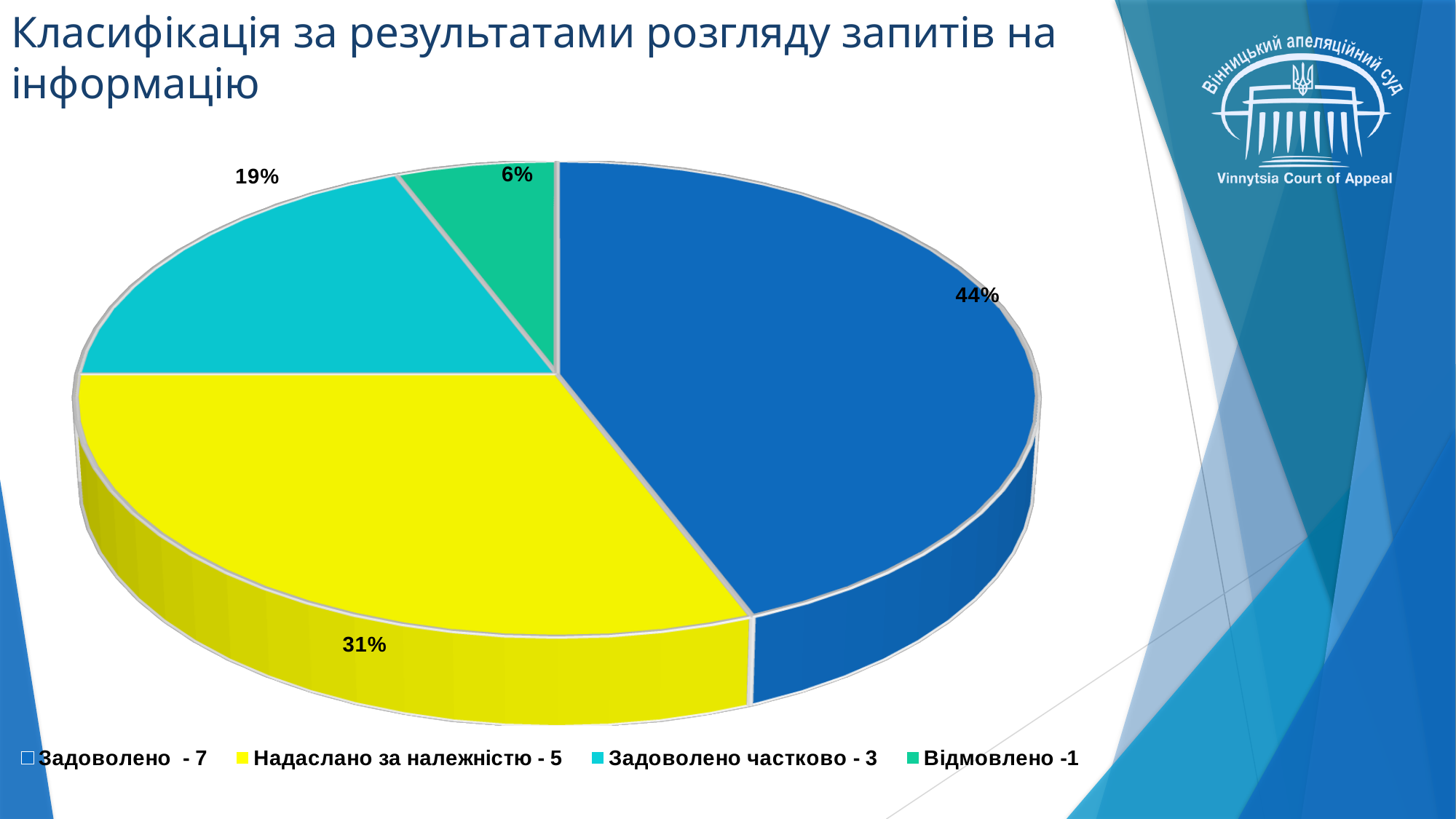
How many slices does the pie chart have? 4 What percentage share is shown for the "Задоволено" slice? 44% What is the difference in percentage points between the "Задоволено" slice and the "Надаслано за належністю" slice? 13% Which category has the smallest share of the pie? Відмовлено According to the legend, how many requests fall under "Надаслано за належністю"? 5 What percentage share is shown for the "Задоволено частково" slice? 19% What percentage share is shown for the "Відмовлено" slice? 6% Which slice is larger: "Задоволено частково" or "Відмовлено"? Задоволено частково What colour is the "Відмовлено" slice in the pie chart? green What kind of chart is shown on the slide? pie chart Which category has the largest share of the pie? Задоволено